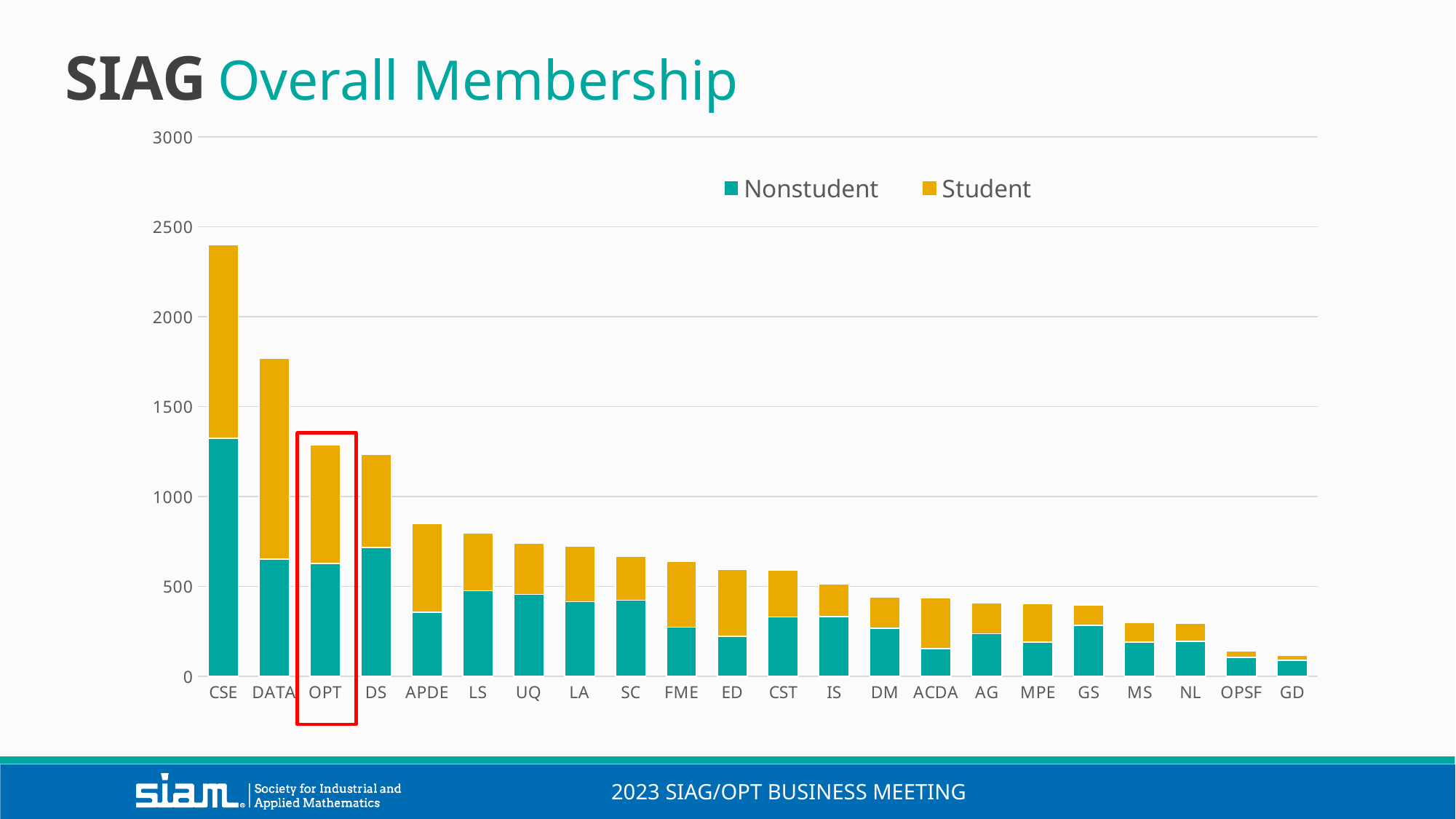
Which has the larger total membership, CSE or DATA? CSE Which SIAG has the highest overall membership? CSE Which SIAG is highlighted with a red box on the chart? OPT How many series does the legend list? 2 Which SIAG has the lowest overall membership? GD Do the total membership values rise or fall moving from left to right along the x axis? fall Is the Nonstudent value for CSE greater or less than 1000? greater How many SIAGs (categories) are shown on the x axis? 22 What kind of chart is shown on the slide? Stacked bar chart Is the total membership for CSE greater or less than 2000? greater Is the total membership for APDE greater or less than 1000? less